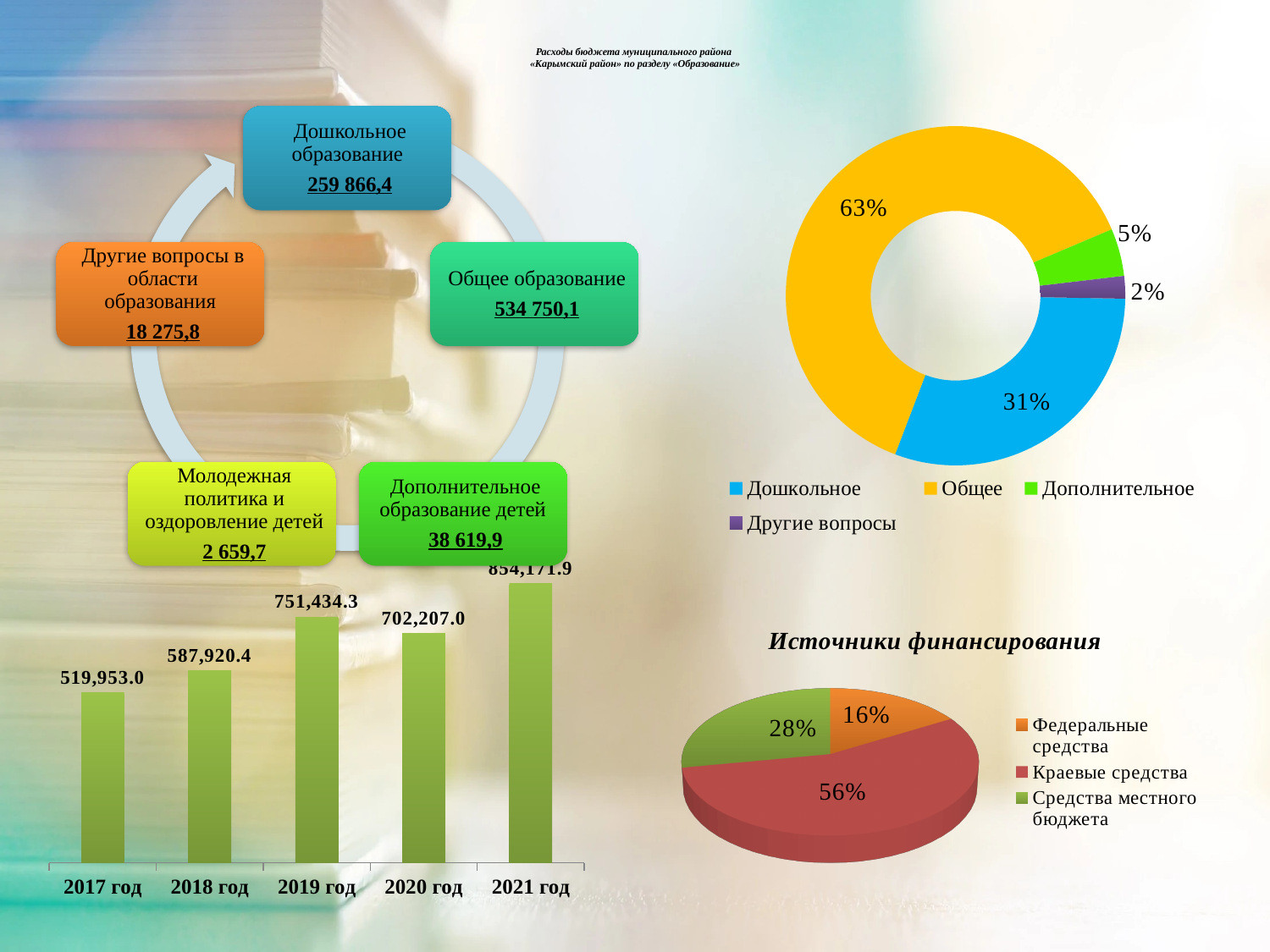
In the doughnut chart at the top right, what share does Общее have? 63% In the doughnut chart at the top right, which category has the smallest share? Другие вопросы In the bar chart at the bottom left, what is the difference between the values for 2018 год and 2017 год? 67,967.4 In the chart titled 'Источники финансирования', what share does Краевые средства have? 56% In the bar chart at the bottom left, which year has the lowest value? 2017 год In the bar chart at the bottom left, what is the value for 2019 год? 751,434.3 How many categories does the legend of the doughnut chart at the top right list? 4 In the bar chart at the bottom left, which is larger: the value for 2019 год or 2020 год? 2019 год In the bar chart at the bottom left, which year has the highest value? 2021 год What kind of chart is the chart titled 'Источники финансирования'? pie chart How many bars are in the bar chart at the bottom left? 5 In the bar chart at the bottom left, what is the value for 2017 год? 519,953.0